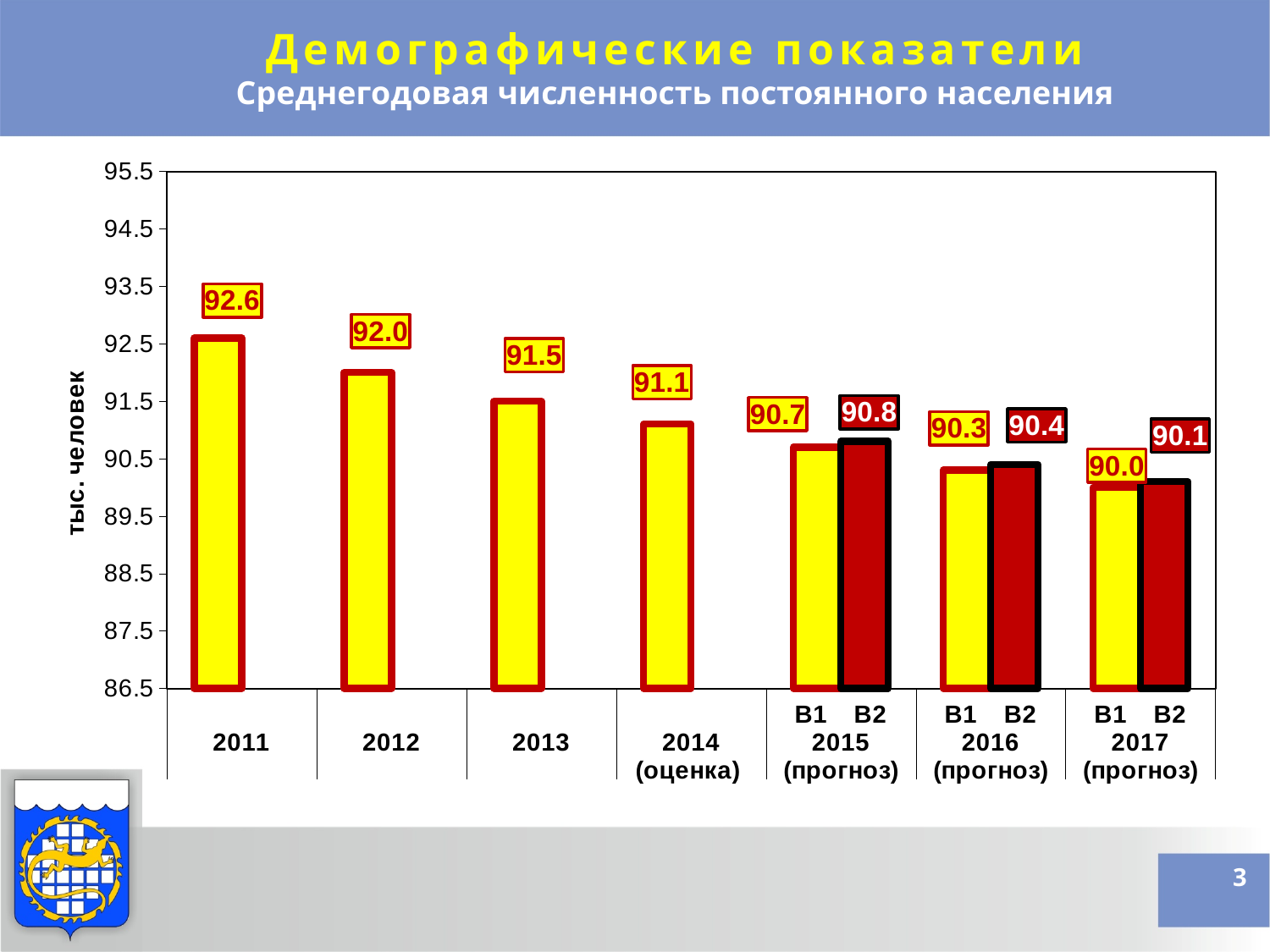
What value is shown for 2014 (оценка)? 91.1 Which is larger, the value for 2013 or the value for 2014 (оценка)? 2013 What is the difference between the 2011 value and the 2012 value? 0.6 What is the label on the vertical axis of the chart? тыс. человек What type of chart is shown on the slide? bar chart What is the average annual permanent population value shown for 2011? 92.6 What is the difference between the В2 and В1 values for 2015 (прогноз)? 0.1 Which year has the highest value on the chart? 2011 What is the В2 value for 2016 (прогноз)? 90.4 Which bar has the lowest value on the chart? В1 2017 (прогноз) Do the values rise or fall from 2011 to 2014? fall What is the В1 value for 2017 (прогноз)? 90.0